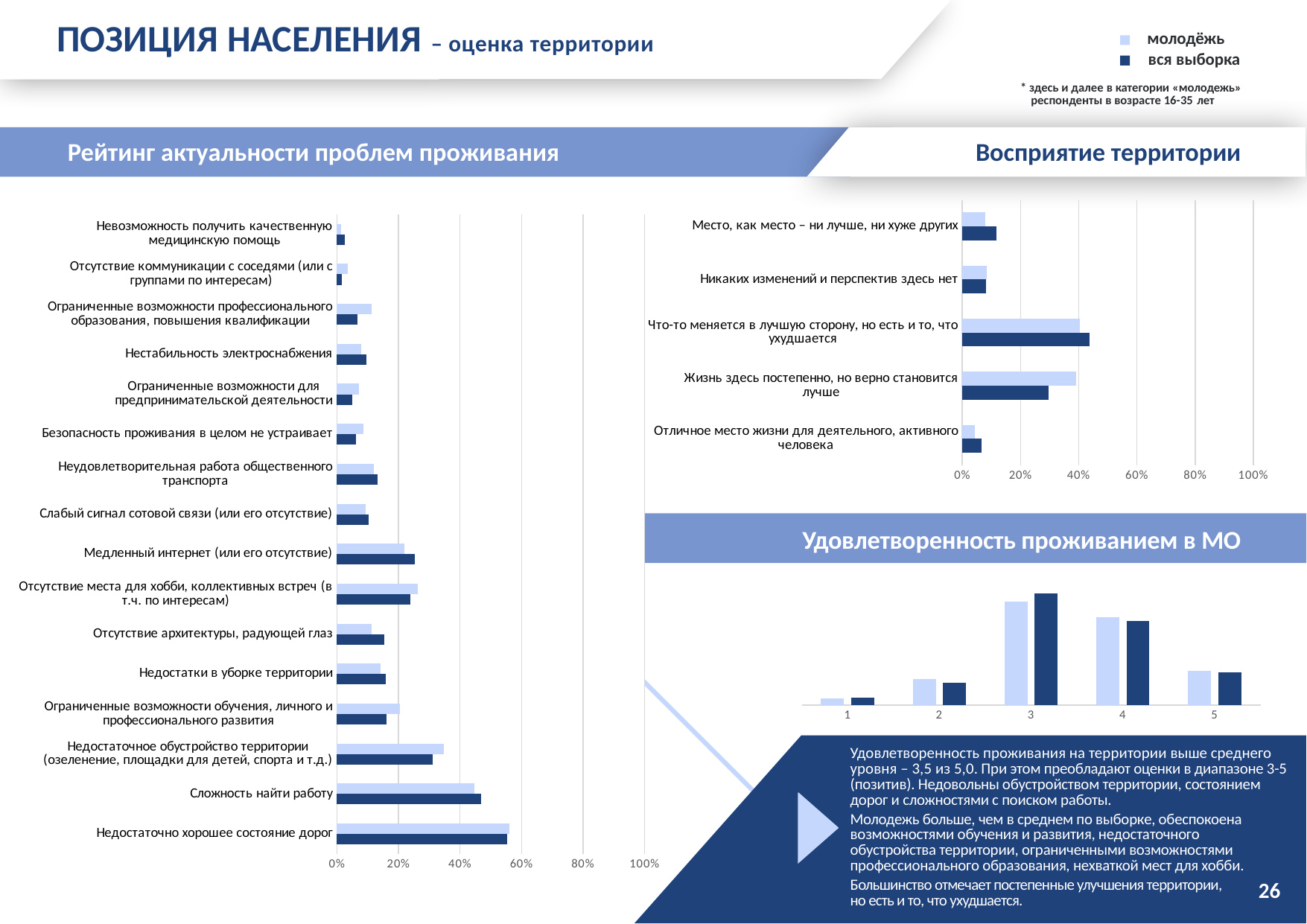
In the chart 'Восприятие территории', which is larger for 'Жизнь здесь постепенно, но верно становится лучше': the 'молодёжь' value or the 'вся выборка' value? молодёжь How many series does the legend on the slide list? 2 How many categories are shown in the chart 'Рейтинг актуальности проблем проживания'? 16 In the chart 'Рейтинг актуальности проблем проживания', is the 'вся выборка' value for 'Недостаточно хорошее состояние дорог' greater or less than 40%? greater In the chart 'Рейтинг актуальности проблем проживания', which category has the highest value for the 'вся выборка' series? Недостаточно хорошее состояние дорог In the chart 'Восприятие территории', is the 'вся выборка' value for 'Жизнь здесь постепенно, но верно становится лучше' greater or less than 40%? less What type of chart is 'Рейтинг актуальности проблем проживания'? bar chart In the chart 'Восприятие территории', which category has the highest value for the 'вся выборка' series? Что-то меняется в лучшую сторону, но есть и то, что ухудшается In the chart 'Удовлетворенность проживанием в МО', which rating has the highest bars? 3 In the chart 'Рейтинг актуальности проблем проживания', is the 'молодёжь' value for 'Недостаточное обустройство территории (озеленение, площадки для детей, спорта и т.д.)' greater or less than 40%? less In the chart 'Удовлетворенность проживанием в МО', which rating has the lowest bars? 1 In the chart 'Рейтинг актуальности проблем проживания', which is larger for 'Медленный интернет (или его отсутствие)': the 'молодёжь' value or the 'вся выборка' value? вся выборка